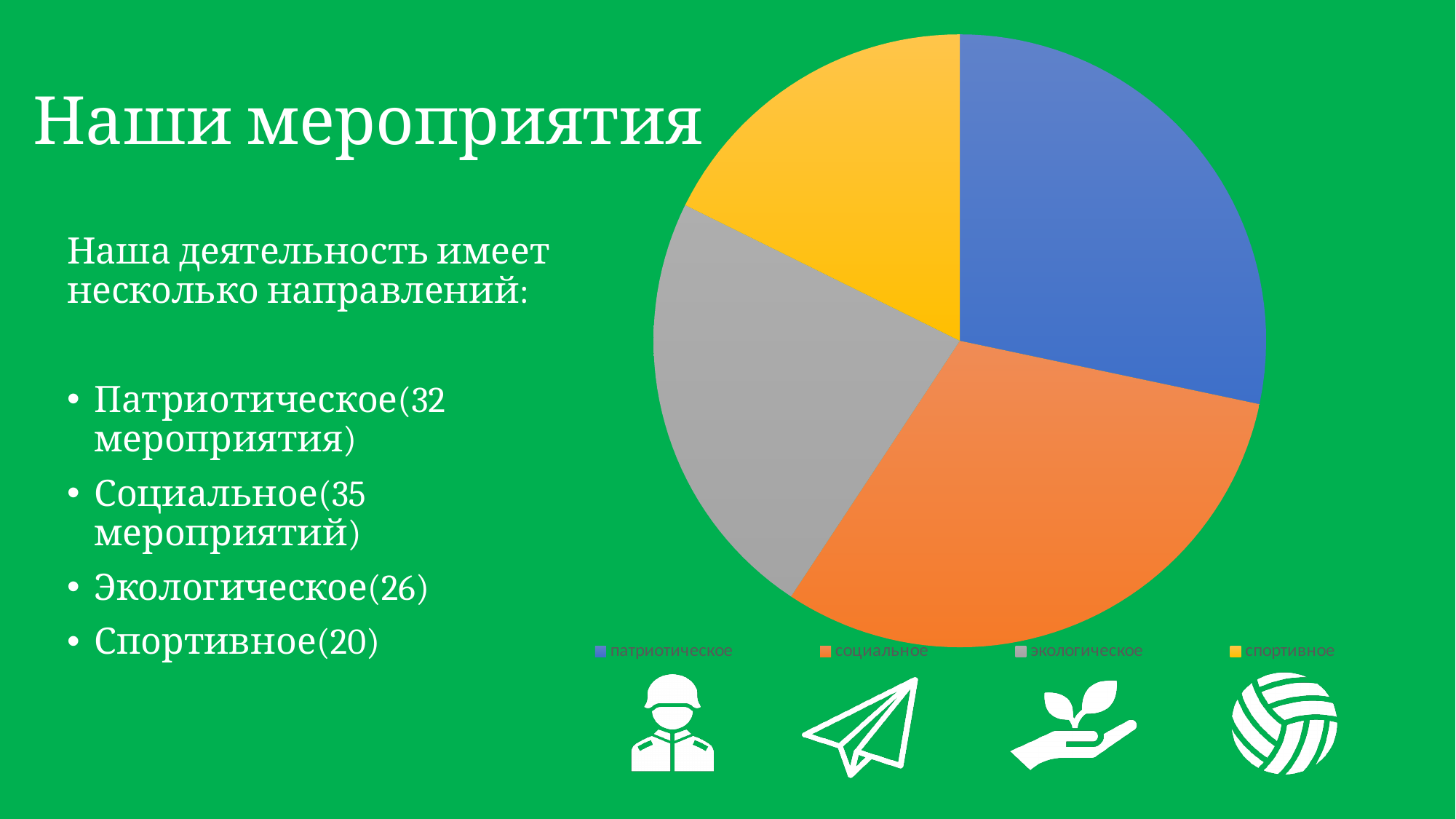
How many events does the slide give for the патриотическое category? 32 What is the difference between the number of социальное events and спортивное events? 15 Which is larger, the экологическое slice or the спортивное slice? экологическое How many events does the slide give for the спортивное category? 20 Which category has the largest slice of the pie chart? социальное How many events does the slide give for the социальное category? 35 How many entries does the legend of the pie chart list? 4 How many slices does the pie chart have? 4 What kind of chart is shown on the slide? pie chart Which category has the smallest slice of the pie chart? спортивное How many events does the slide give for the экологическое category? 26 What colour is the социальное slice in the pie chart? orange